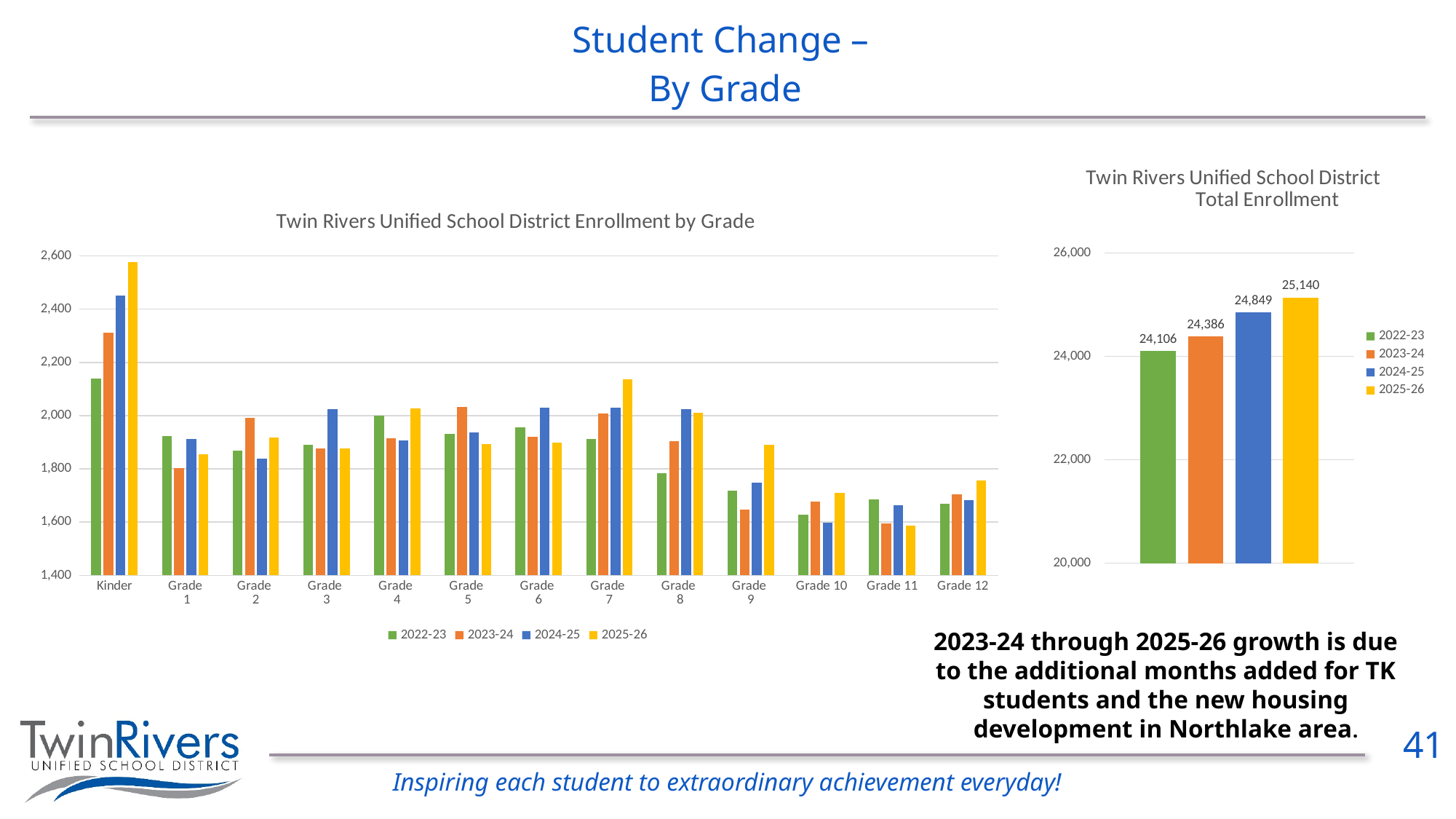
In the Twin Rivers Unified School District Enrollment by Grade chart, is the 2025-26 value for Kinder greater or less than 2,400? greater In the Twin Rivers Unified School District Total Enrollment chart, which year has the lowest total enrollment? 2022-23 In the Twin Rivers Unified School District Enrollment by Grade chart, which grade has the highest 2025-26 enrollment? Kinder What kind of chart is the Twin Rivers Unified School District Enrollment by Grade chart? bar chart In the Twin Rivers Unified School District Enrollment by Grade chart, how many grade categories are shown on the x axis? 13 In the Twin Rivers Unified School District Total Enrollment chart, what is the total enrollment for 2025-26? 25,140 In the Twin Rivers Unified School District Total Enrollment chart, what is the difference between the 2025-26 and 2022-23 totals? 1,034 In the Twin Rivers Unified School District Total Enrollment chart, do the values rise or fall from 2022-23 to 2025-26? rise In the Twin Rivers Unified School District Total Enrollment chart, what is the total enrollment for 2022-23? 24,106 In the Twin Rivers Unified School District Enrollment by Grade chart, how many series does the legend list? 4 In the Twin Rivers Unified School District Total Enrollment chart, which year has the highest total enrollment? 2025-26 In the Twin Rivers Unified School District Enrollment by Grade chart, is the 2022-23 value for Grade 10 greater or less than 1,800? less